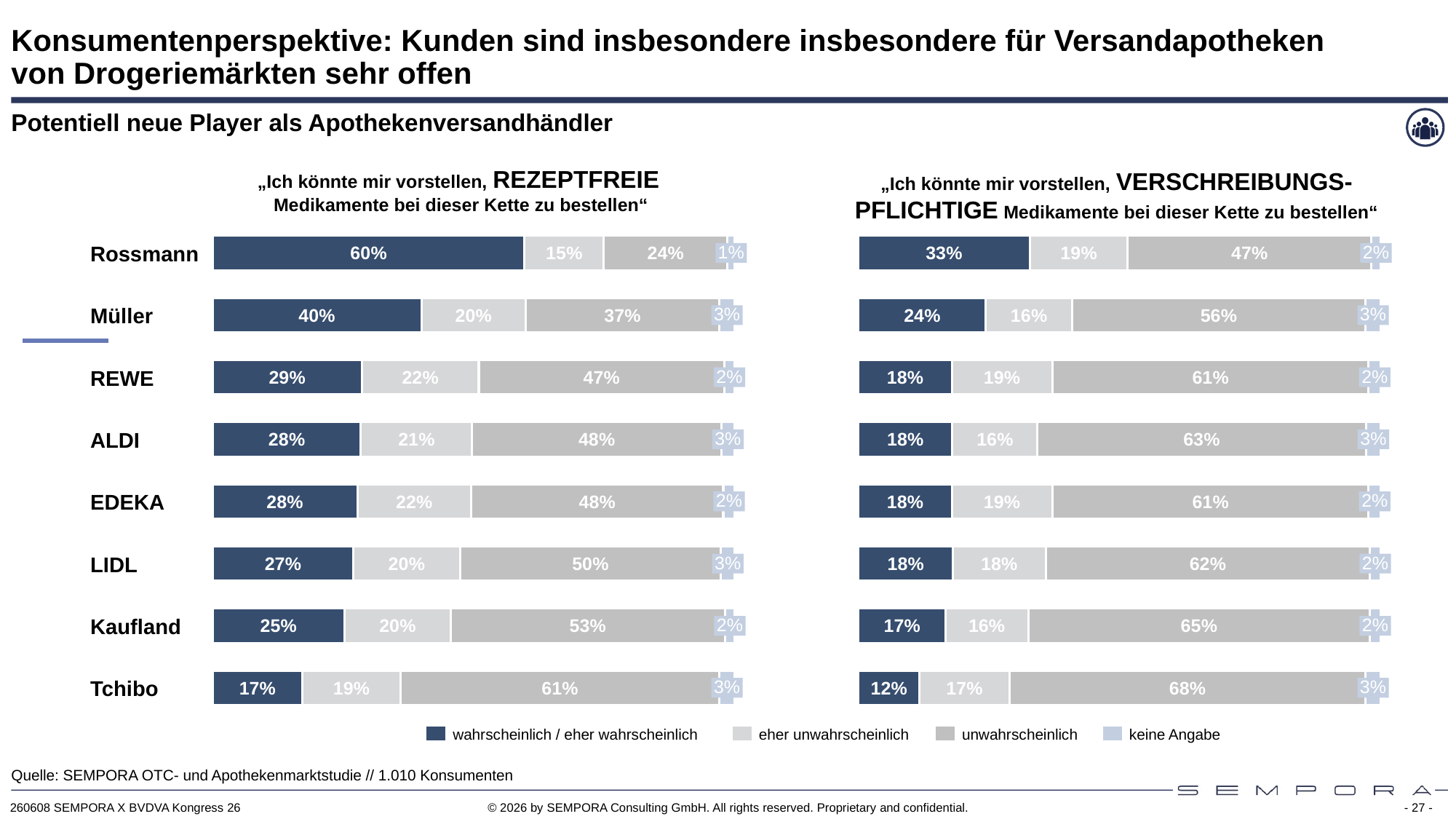
In the left chart (REZEPTFREIE Medikamente), what share of respondents answered "wahrscheinlich / eher wahrscheinlich" for Rossmann? 60% In the right chart (VERSCHREIBUNGSPFLICHTIGE Medikamente), which chain has the lowest "wahrscheinlich / eher wahrscheinlich" share? Tchibo How many chains are listed as categories in each chart? 8 In the left chart (REZEPTFREIE Medikamente), which chain has the highest "wahrscheinlich / eher wahrscheinlich" share? Rossmann How many series does the legend list? 4 In the right chart (VERSCHREIBUNGSPFLICHTIGE Medikamente), which is larger: the "unwahrscheinlich" share for Kaufland or for REWE? Kaufland What kind of chart is used on this slide? Stacked bar chart In the right chart (VERSCHREIBUNGSPFLICHTIGE Medikamente), what share of respondents answered "unwahrscheinlich" for Tchibo? 68% Which legend entry is shown in dark blue? wahrscheinlich / eher wahrscheinlich In the left chart (REZEPTFREIE Medikamente), what is the "eher unwahrscheinlich" share for REWE? 22% In the left chart (REZEPTFREIE Medikamente), what is the difference between the "wahrscheinlich / eher wahrscheinlich" shares of Rossmann and Müller? 20 percentage points In the right chart (VERSCHREIBUNGSPFLICHTIGE Medikamente), what is the "keine Angabe" share for Müller? 3%